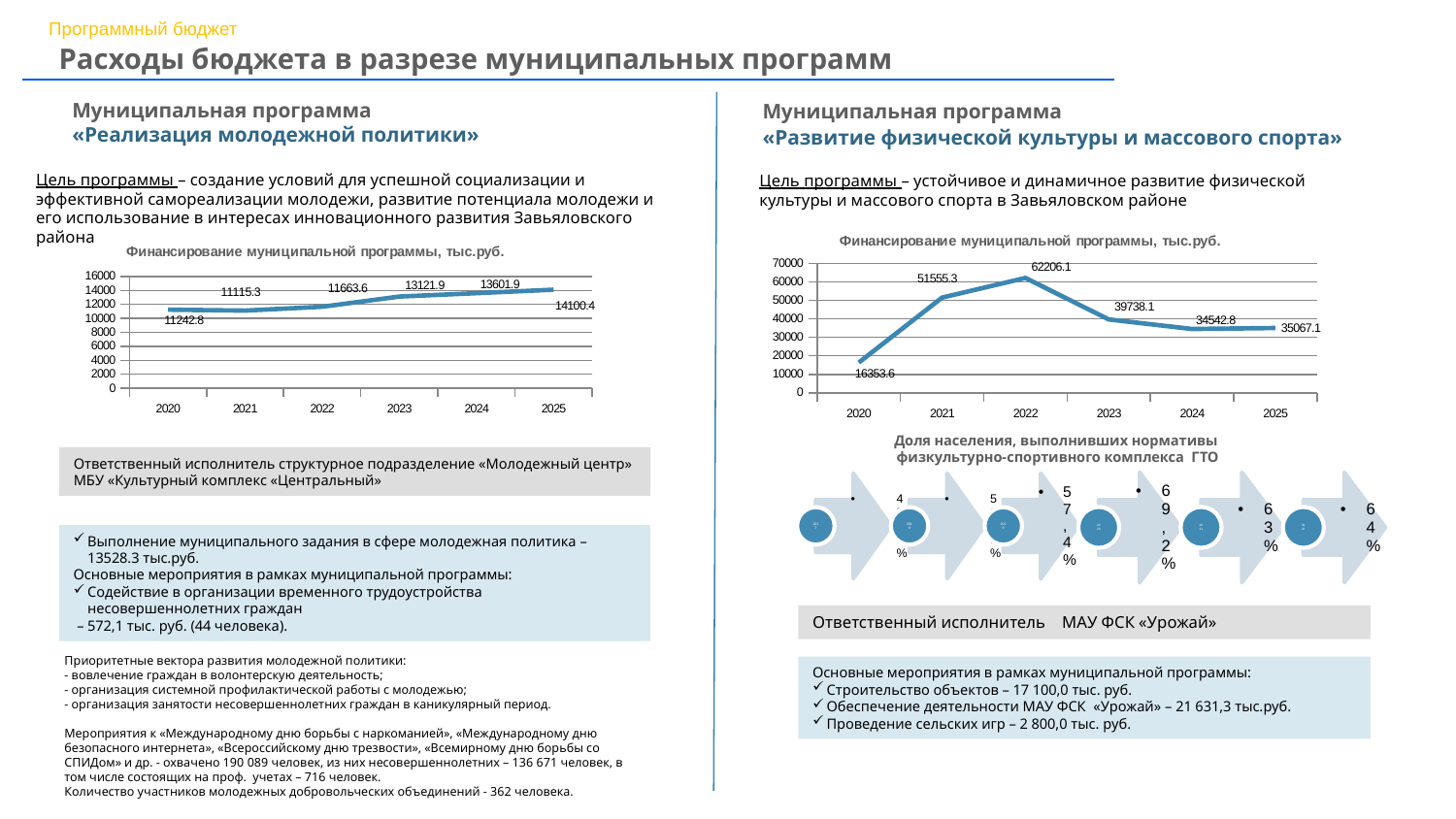
On the left chart (Реализация молодежной политики), what is the difference between the 2025 and 2024 values? 498.5 On the right chart (Развитие физической культуры и массового спорта), what is the difference between the 2022 and 2023 values? 22468.0 On the left chart (Реализация молодежной политики), which year has the lowest funding value? 2021 On the left chart (Реализация молодежной политики), how many years are plotted on the x axis? 6 On the left chart (Реализация молодежной политики), what is the funding value for 2020? 11242.8 On the left chart (Реализация молодежной политики), what is the funding value for 2023? 13121.9 On the right chart (Развитие физической культуры и массового спорта), which year has the highest funding value? 2022 On the right chart (Развитие физической культуры и массового спорта), what is the funding value for 2020? 16353.6 What type of chart is used on the right side of the slide to show the funding of the physical culture program? Line chart On the right chart (Развитие физической культуры и массового спорта), what is the funding value for 2022? 62206.1 On the left chart (Реализация молодежной политики), which year has the highest funding value? 2025 On the right chart (Развитие физической культуры и массового спорта), which is larger, the value for 2024 or the value for 2025? 2025